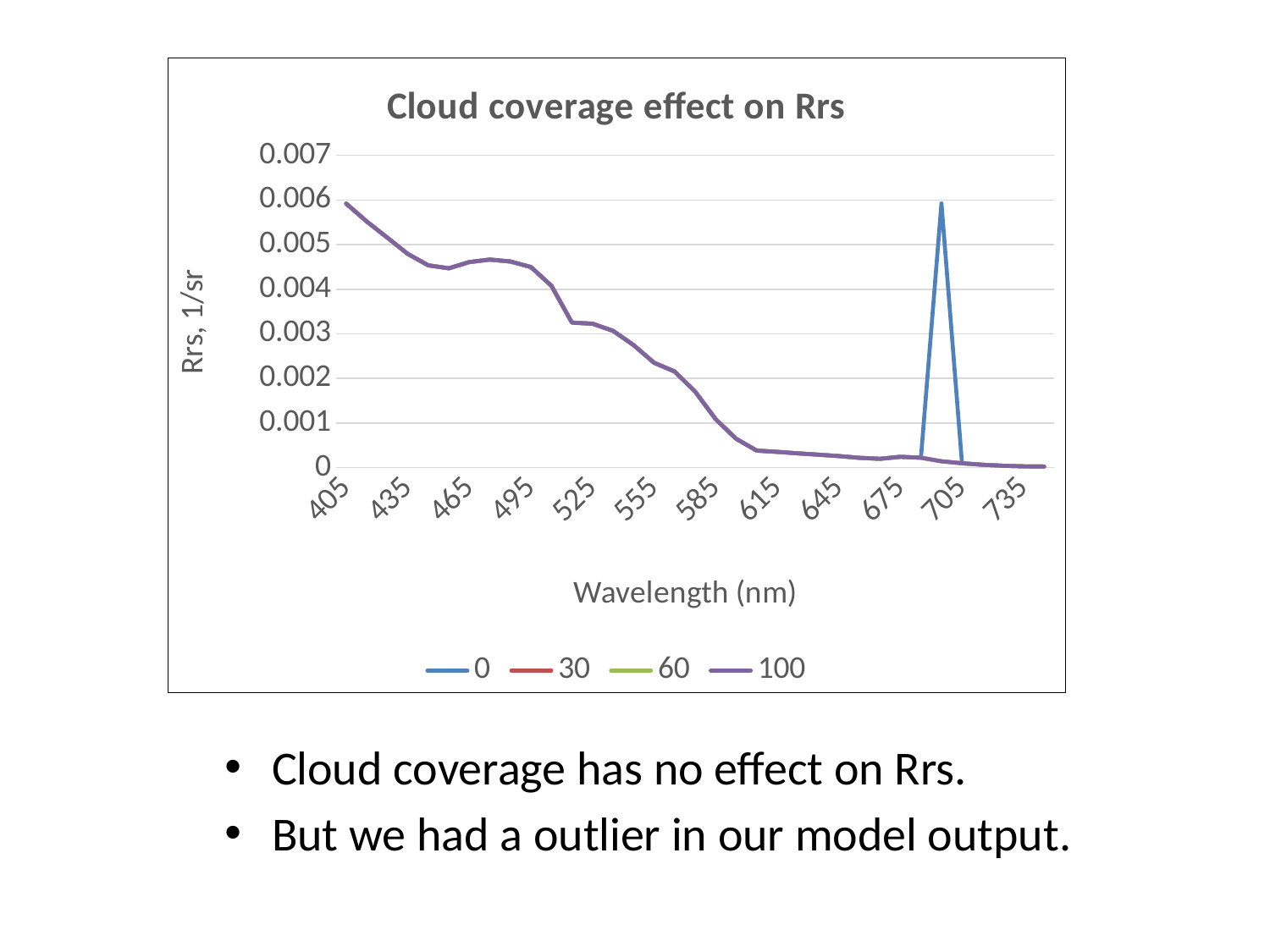
Is the peak of the spike in the series labelled 0 near 700 nm greater or less than 0.005? greater Overall, do the Rrs values rise or fall as wavelength increases from 405 nm to 735 nm? fall What is the label of the y axis? Rrs, 1/sr Is the Rrs value at 615 nm greater or less than 0.001? less Is the Rrs value at 525 nm greater or less than 0.004? less What is the title of the chart? Cloud coverage effect on Rrs How many series does the chart's legend list? 4 What kind of chart is shown on the slide? line chart Which is larger, the Rrs value at 405 nm or the Rrs value at 735 nm? 405 nm At which wavelength tick does the series labelled 100 reach its highest value? 405